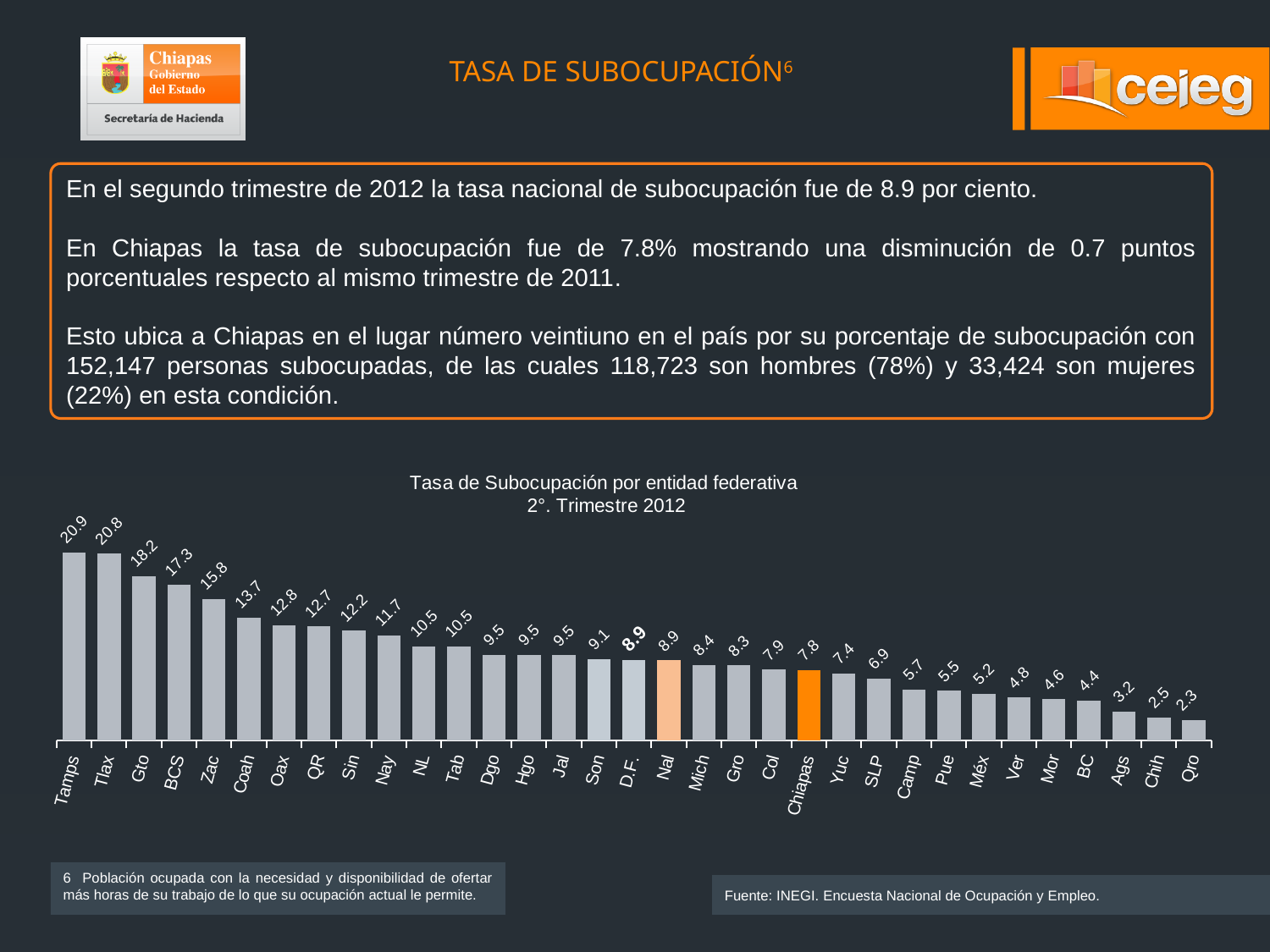
What is the value for Tamps in the chart? 20.9 Which entity has the highest subocupación rate in the chart? Tamps What is the value for Nal (national) in the chart? 8.9 What is the difference between the Nal value and the Chiapas value? 1.1 What is the value for Chiapas in the chart? 7.8 What is the title of the chart? Tasa de Subocupación por entidad federativa 2°. Trimestre 2012 What kind of chart is shown on the slide? Bar chart How many bars are plotted in the chart? 33 Do the values rise or fall from left to right along the x axis? Fall Which is larger, the value for Gto or the value for Zac? Gto What is the value for Qro in the chart? 2.3 What is the difference between the values for Tamps and Chiapas? 13.1